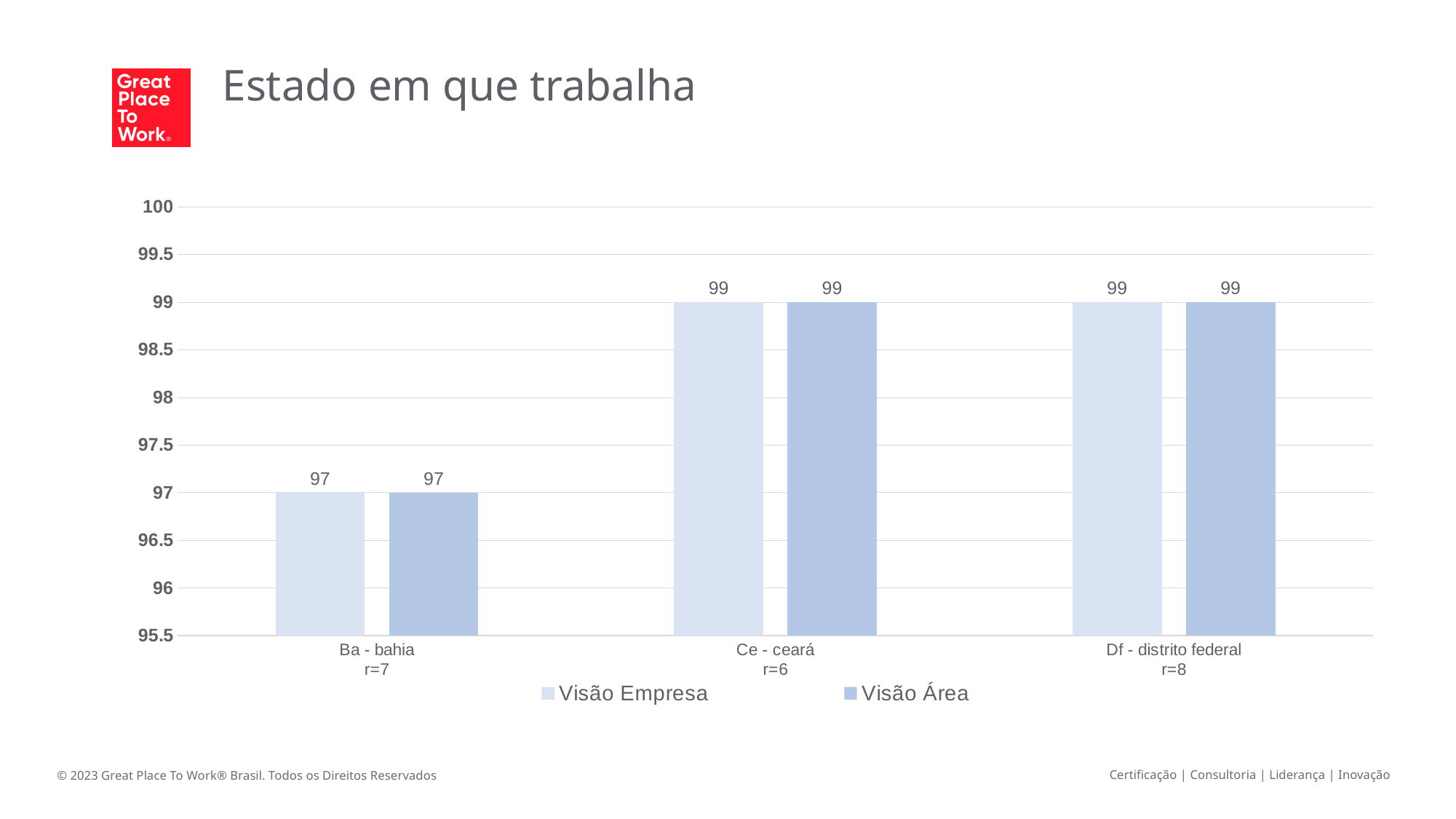
What is the Visão Empresa value for Ba - bahia? 97 Which category has the lowest Visão Área value? Ba - bahia How many series does the legend list? 2 What is the difference between the Visão Empresa values for Ce - ceará and Ba - bahia? 2 What is the title of the chart? Estado em que trabalha Which is larger: the Visão Área value for Df - distrito federal or for Ba - bahia? Df - distrito federal Is the Visão Empresa value for Ba - bahia greater or less than 98? less What is the Visão Empresa value for Df - distrito federal? 99 What is the Visão Área value for Ce - ceará? 99 What is the r value shown under the Ce - ceará category label? r=6 What kind of chart is shown on the slide? bar chart How many categories are shown on the x axis? 3